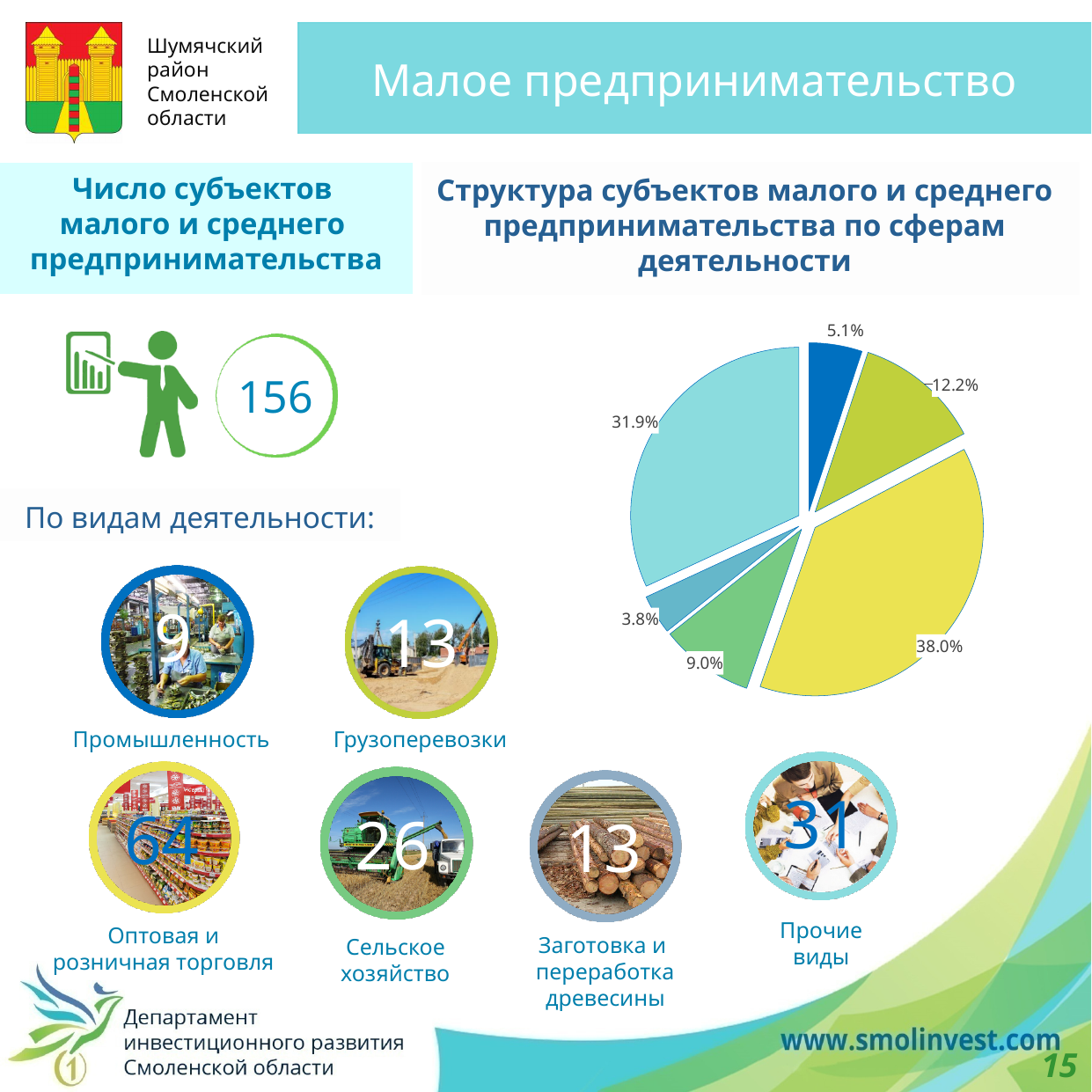
In the pie chart, which slice is larger: the one labelled 12.2% or the one labelled 9.0%? 12.2% What colour is the largest slice (38.0%) in the pie chart? yellow What is the combined share of the two slices labelled 5.1% and 12.2% in the pie chart? 17.3% How many slices in the pie chart are larger than 30%? 2 How many slices does the pie chart have? 6 What is the percentage of the second-largest slice in the pie chart? 31.9% What is the percentage of the smallest slice in the pie chart? 3.8% What kind of chart is shown under the title «Структура субъектов малого и среднего предпринимательства по сферам деятельности»? pie chart What is the title of the pie chart on the slide? Структура субъектов малого и среднего предпринимательства по сферам деятельности What is the percentage of the dark blue slice in the pie chart? 5.1% By how many percentage points does the largest slice (38.0%) exceed the second-largest slice (31.9%) in the pie chart? 6.1 What is the percentage of the largest slice in the pie chart? 38.0%